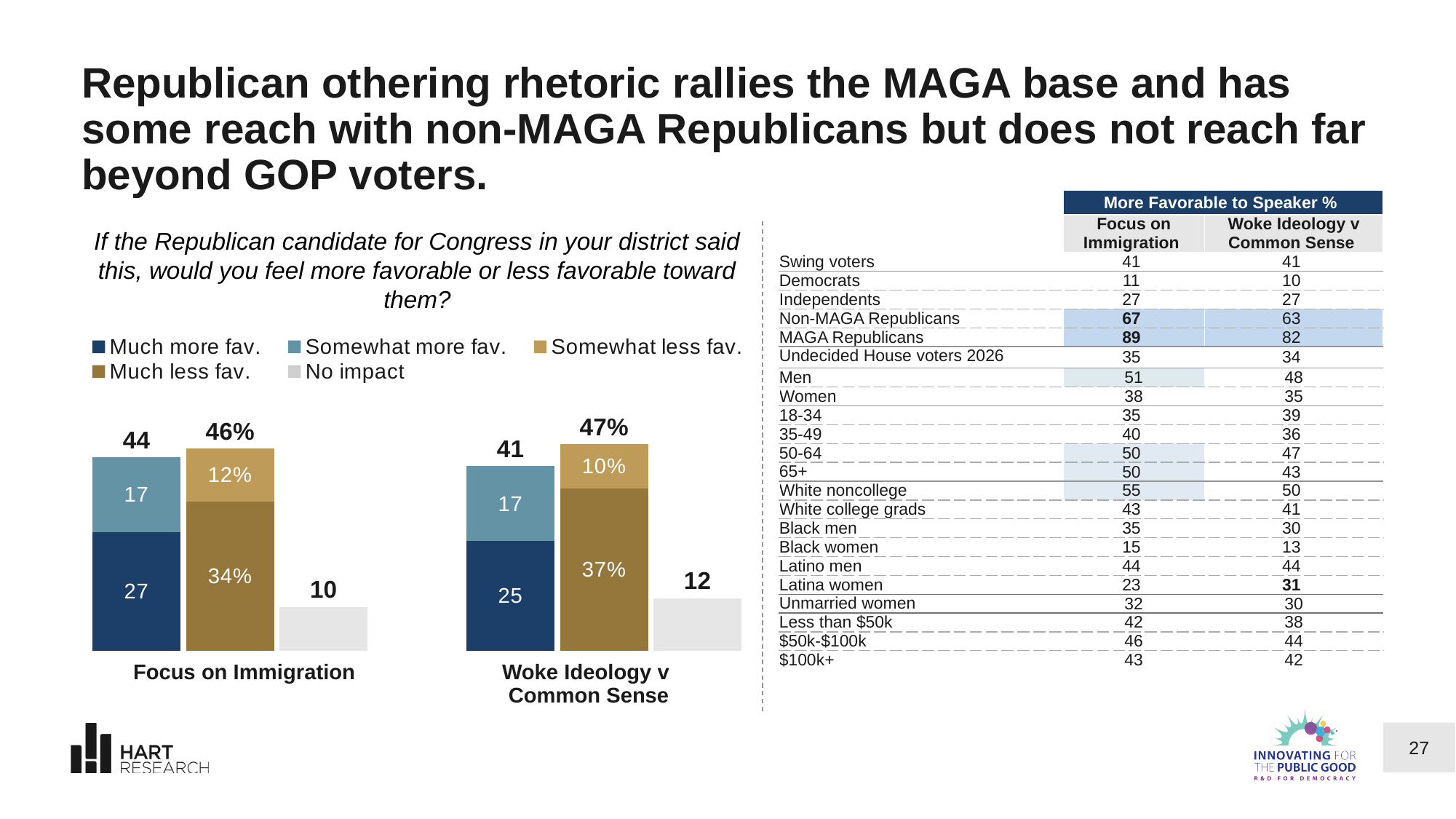
What kind of chart is used to show the Focus on Immigration results? Stacked bar chart In the Woke Ideology v Common Sense chart, what is the value for "Much less fav."? 37% In the Woke Ideology v Common Sense chart, what is the difference between the "Much less fav." value and the "Much more fav." value? 12 How many series does the legend list for the bar charts? 5 In the Woke Ideology v Common Sense chart, what is the total of the stacked bar combining "Much less fav." and "Somewhat less fav."? 47% In the bar charts, which colour represents "Much more fav."? Dark blue In the Woke Ideology v Common Sense chart, what is the value for "Somewhat less fav."? 10% In the Focus on Immigration chart, what is the value for "Much more fav."? 27 Which chart has the higher "No impact" value, Focus on Immigration or Woke Ideology v Common Sense? Woke Ideology v Common Sense In the Focus on Immigration chart, which is larger: the total more favorable bar or the total less favorable bar? The less favorable bar (46%) In the Focus on Immigration chart, what is the total of the stacked bar combining "Much more fav." and "Somewhat more fav."? 44 In the Focus on Immigration chart, what is the value for "No impact"? 10